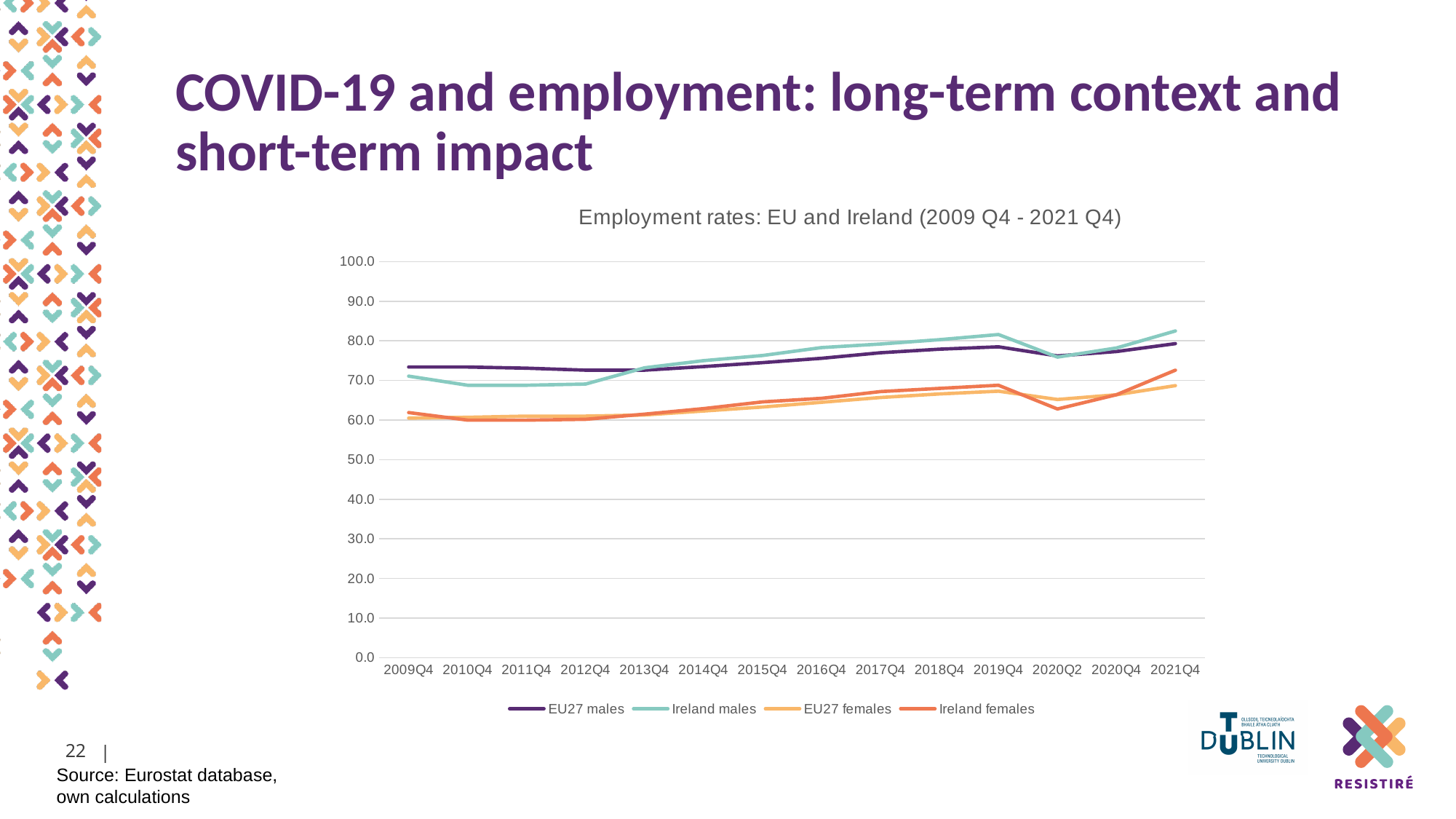
What is the title of the chart? Employment rates: EU and Ireland (2009 Q4 - 2021 Q4) Is the value for EU27 females at 2009Q4 greater or less than 70? less Is the value for Ireland males at 2021Q4 greater or less than 80? greater Is the value for Ireland females at 2020Q2 greater or less than 60? greater At 2021Q4, which is larger: Ireland females or EU27 females? Ireland females At 2010Q4, which is larger: EU27 males or Ireland males? EU27 males How many series does the legend list? 4 How many time points are shown on the x axis? 14 What kind of chart is shown on the slide? Line chart Which series is lowest at 2021Q4? EU27 females Which series is highest at 2021Q4? Ireland males Does the Ireland males series rise or fall between 2019Q4 and 2020Q2? fall